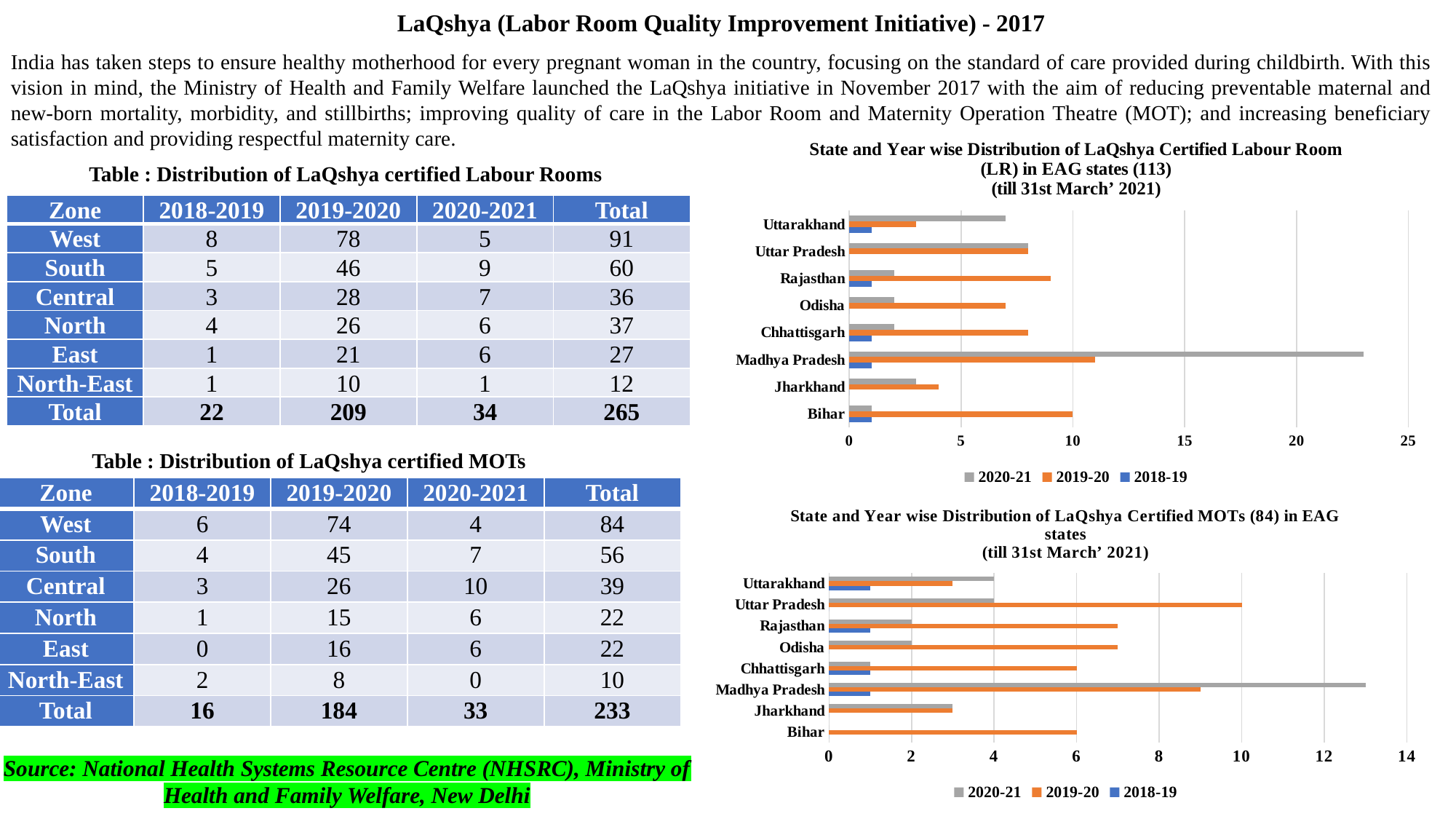
What total number of certified MOTs in EAG states is given in the title of the MOTs chart? 84 In the Labour Room (LR) chart, which is larger for 2019-20: Madhya Pradesh or Rajasthan? Madhya Pradesh In the MOTs chart, which is larger for 2020-21: Madhya Pradesh or Uttar Pradesh? Madhya Pradesh In the Labour Room (LR) chart, is the 2020-21 value for Madhya Pradesh greater or less than 20? greater In the MOTs chart, is the 2020-21 value for Madhya Pradesh greater or less than 12? greater In the Labour Room (LR) chart, which state has the longest 2020-21 bar? Madhya Pradesh In the MOTs chart, which state has the longest 2019-20 bar? Uttar Pradesh What kind of chart is the 'State and Year wise Distribution of LaQshya Certified Labour Room (LR) in EAG states' chart? Bar chart How many series does the legend of the MOTs chart list? 3 In the MOTs chart, is the 2020-21 value for Odisha greater or less than 4? less How many states are shown on the Labour Room (LR) chart? 8